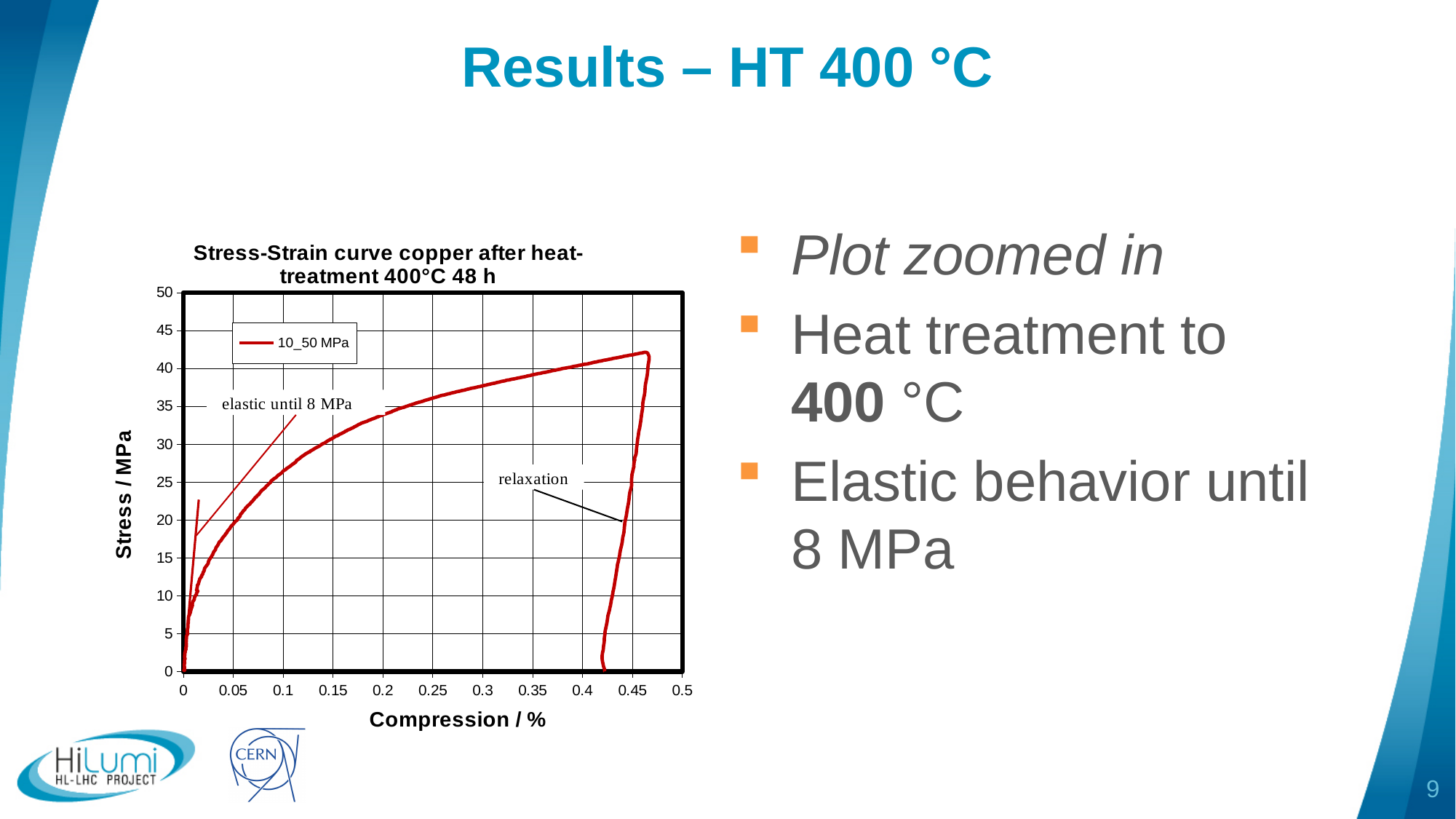
What kind of chart is shown on the slide? line chart What is the highest value shown on the y axis of the chart? 50 Is the peak stress reached by the curve greater or less than 40 MPa? greater What is the name of the series shown in the chart legend? 10_50 MPa What is the title of the chart? Stress-Strain curve copper after heat-treatment 400°C 48 h Along the loading part of the curve, does the stress rise or fall as compression increases? rise Is the stress at a compression of 0.3 % greater or less than 35 MPa? greater How many series does the chart legend list? 1